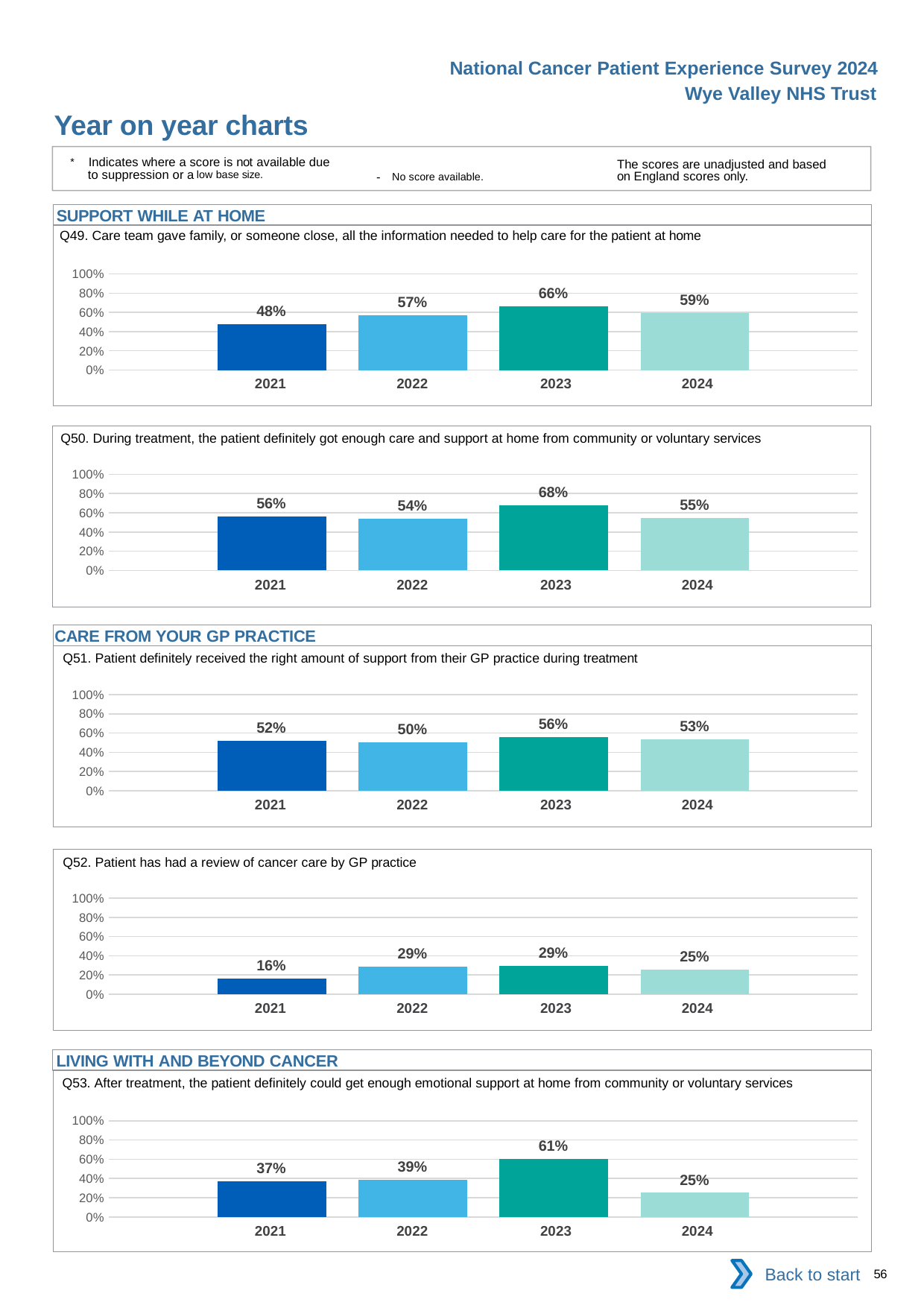
In the Q49 chart, how many years are plotted? 4 In the Q53 chart, what is the value for 2024? 25% In the Q52 chart, which year has the lowest value? 2021 In the Q49 chart, is the value for 2021 greater or less than 60%? less In the Q50 chart, which year has the highest value? 2023 What kind of chart is the Q52 chart? bar chart In the Q52 chart, what is the value for 2022? 29% In the Q49 chart, what is the value for 2023? 66% Which section heading appears above the Q53 chart? LIVING WITH AND BEYOND CANCER In the Q51 chart, what is the difference between the 2023 and 2022 values? 6% In the Q50 chart, what is the difference between the 2023 and 2024 values? 13% In the Q53 chart, is the value for 2023 greater or less than 2022? greater